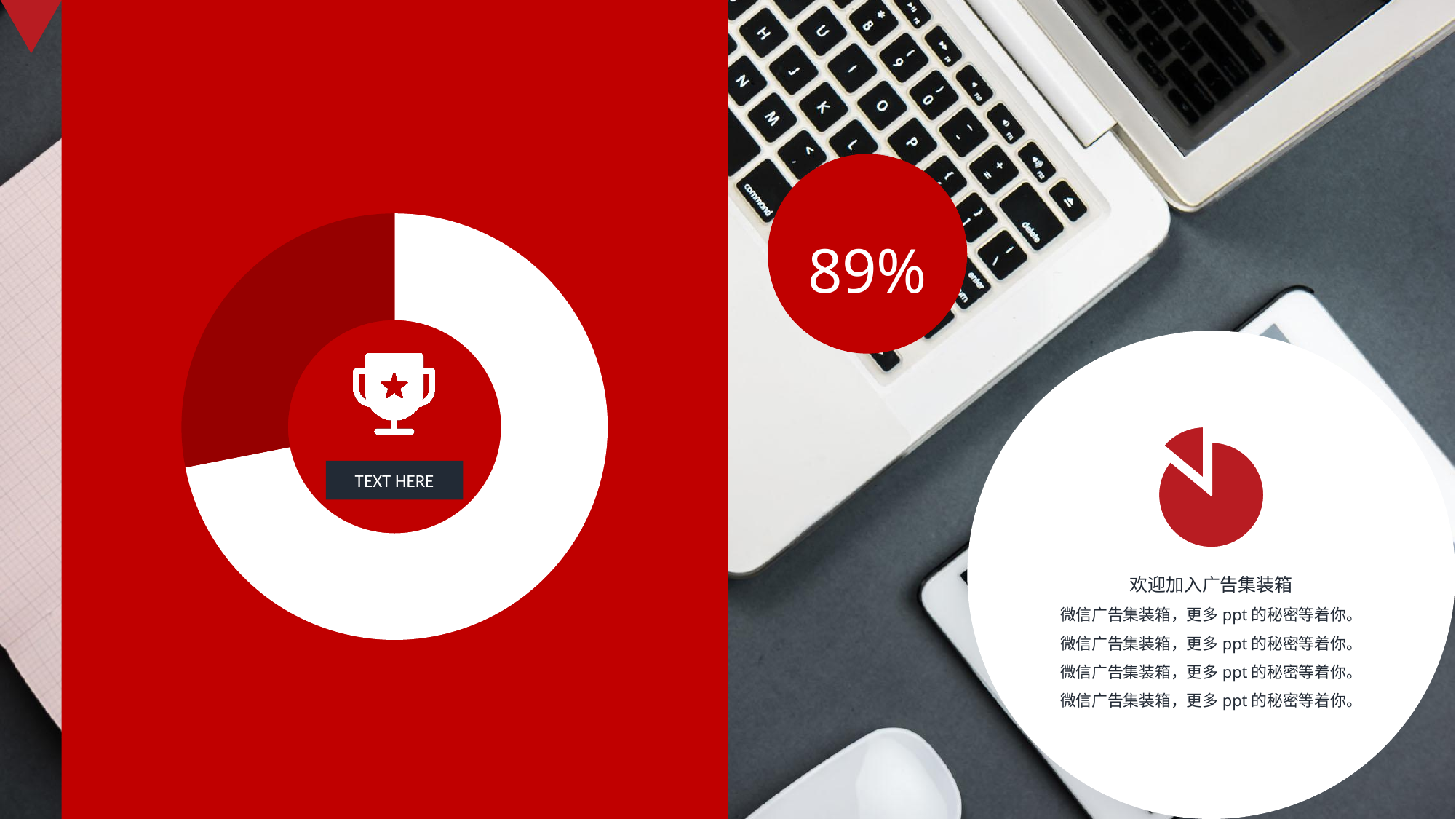
In the doughnut chart, which segment is larger, the white one or the dark red one? The white one Which segment of the doughnut chart is the smallest? The dark red segment What text is shown in the dark box at the centre of the doughnut chart? TEXT HERE What colour is the larger segment of the doughnut chart? White What kind of chart is shown on the left side of the slide? Doughnut chart How many segments does the doughnut chart on the left have? 2